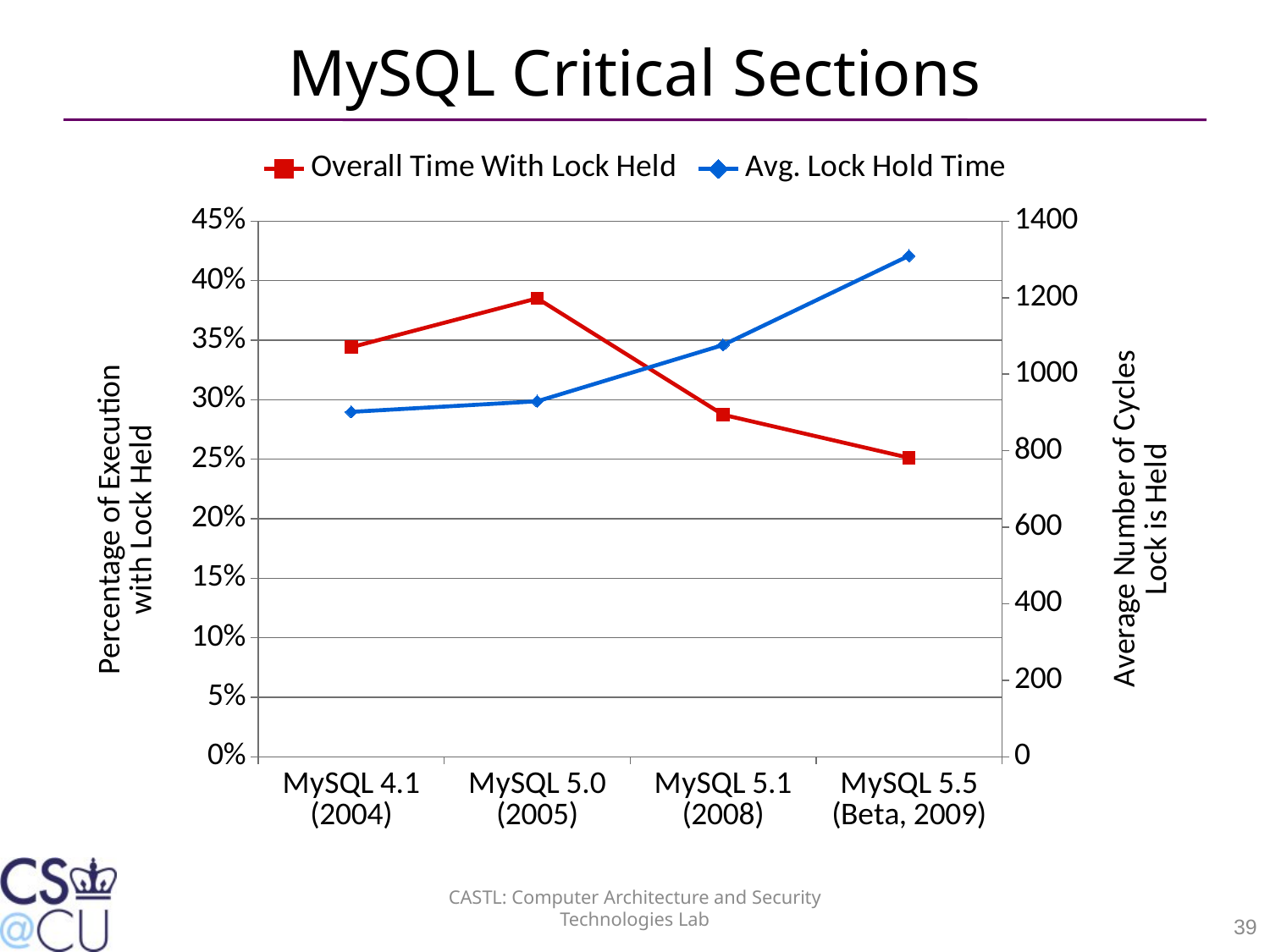
How many MySQL versions are plotted along the x axis? 4 Is the Overall Time With Lock Held for MySQL 5.0 (2005) greater or less than 35%? greater For which MySQL version is Overall Time With Lock Held highest? MySQL 5.0 (2005) What kind of chart is shown on the slide? line chart Does Avg. Lock Hold Time rise or fall across the MySQL versions from left to right? rise Is the Avg. Lock Hold Time for MySQL 4.1 (2004) greater or less than 1000 cycles? less For which MySQL version is Overall Time With Lock Held lowest? MySQL 5.5 (Beta, 2009) How many series does the legend list? 2 Is the Overall Time With Lock Held for MySQL 5.5 (Beta, 2009) greater or less than 30%? less Which has a higher Overall Time With Lock Held, MySQL 4.1 (2004) or MySQL 5.1 (2008)? MySQL 4.1 (2004) For which MySQL version is Avg. Lock Hold Time highest? MySQL 5.5 (Beta, 2009)